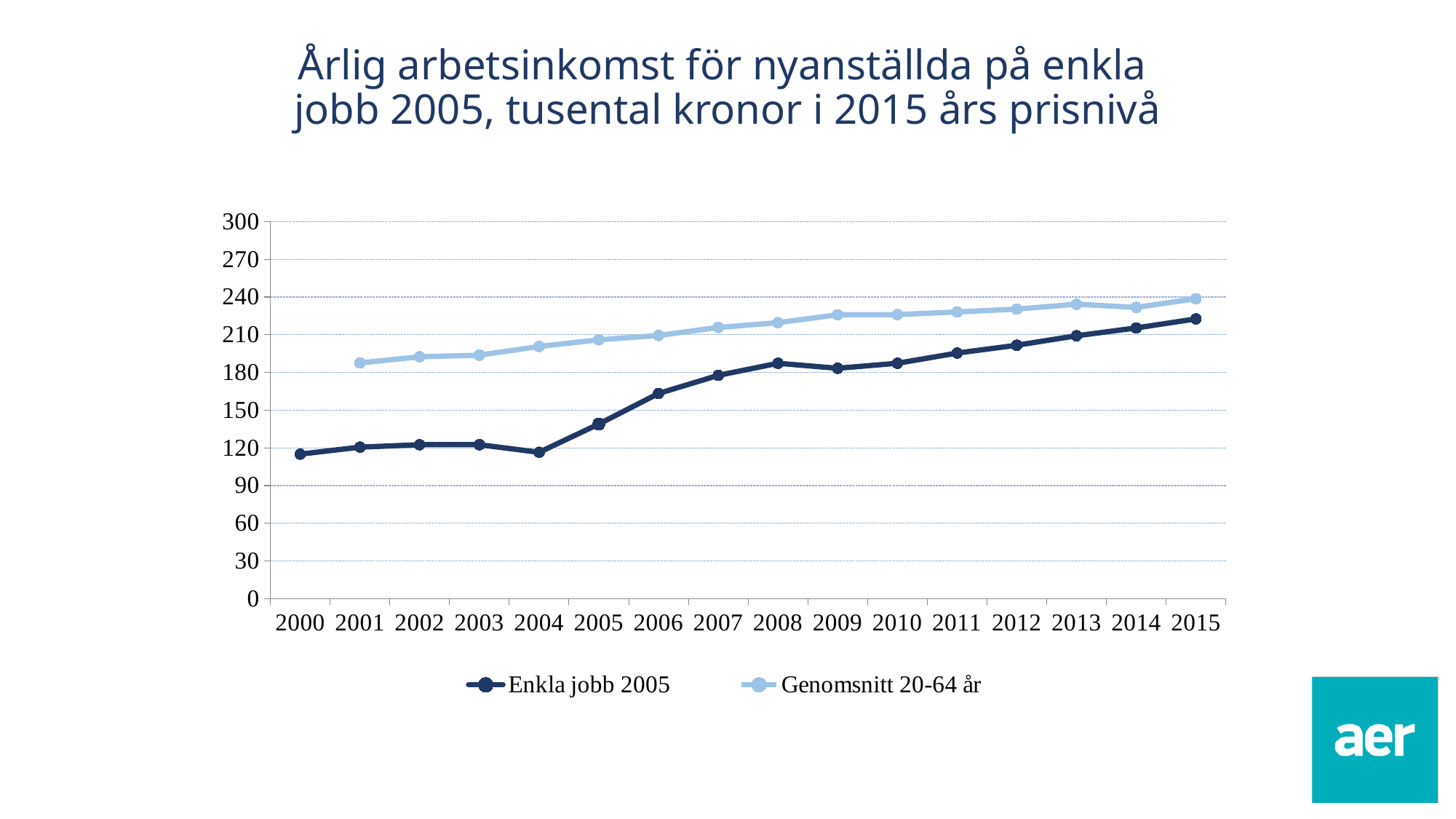
How many series does the legend list? 2 What are the two series named in the legend? Enkla jobb 2005 and Genomsnitt 20-64 år Is the value for Enkla jobb 2005 in 2005 greater or less than 150? less Is the value for Enkla jobb 2005 in 2006 greater or less than 150? greater What kind of chart is shown on the slide? line chart How many years are shown on the x axis? 16 Is the value for Enkla jobb 2005 in 2015 greater or less than 210? greater In 2010, which series has the higher value, Enkla jobb 2005 or Genomsnitt 20-64 år? Genomsnitt 20-64 år In which year does the Genomsnitt 20-64 år series have its lowest value? 2001 Does the Enkla jobb 2005 series rise or fall between 2004 and 2008? rise In which year does the Enkla jobb 2005 series reach its highest value? 2015